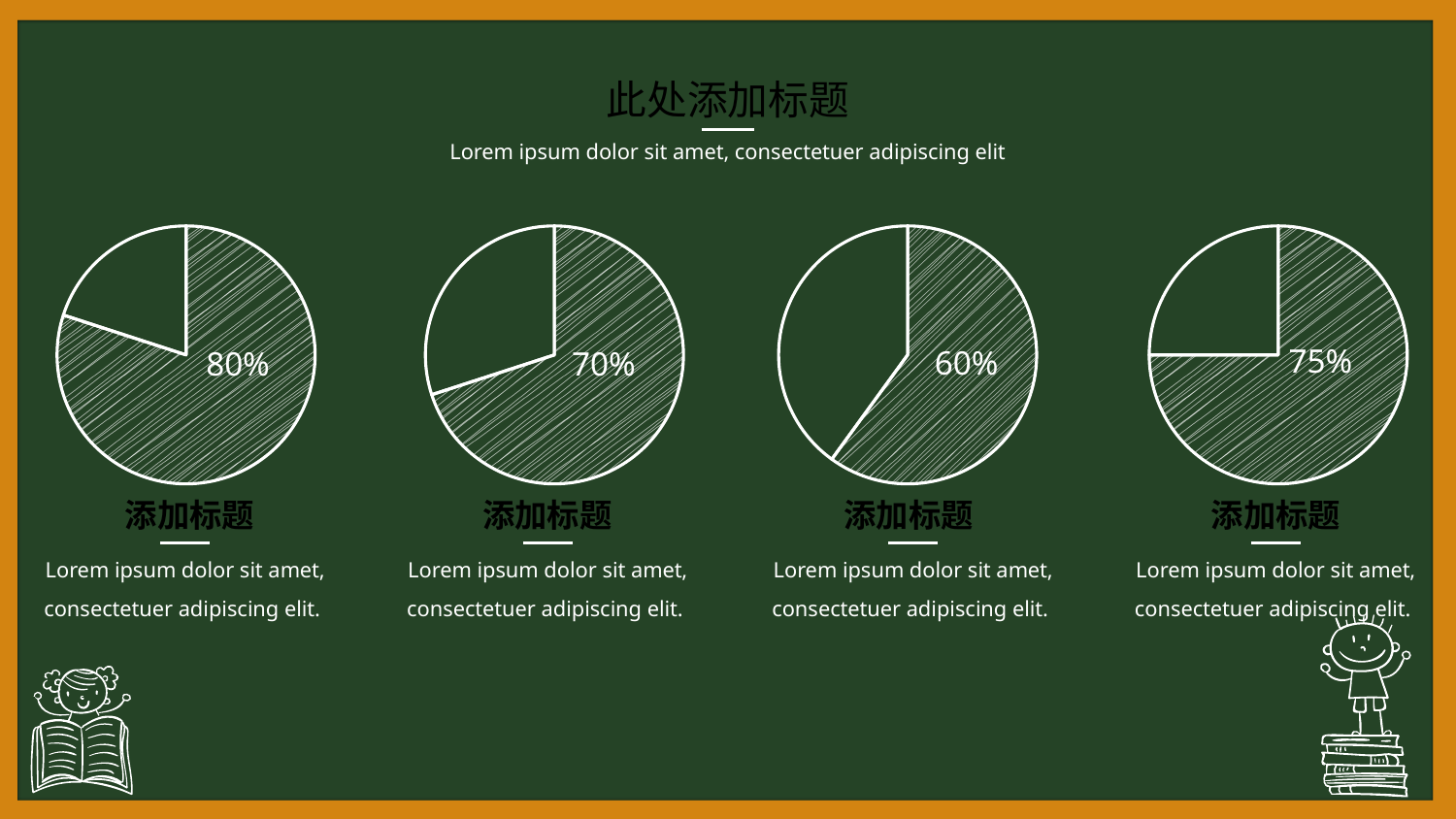
What kind of charts are shown on the slide? Pie charts What value is shown on the rightmost pie chart? 75% Which is larger: the percentage on the second pie chart or the percentage on the rightmost pie chart? The rightmost pie chart (75%) What value is shown on the leftmost pie chart? 80% Which pie chart shows the lowest percentage? The third pie chart from the left (60%) What value is shown on the third pie chart from the left? 60% What is the main title at the top of the slide? 此处添加标题 What is the difference between the percentage on the leftmost pie chart and the percentage on the third pie chart? 20 percentage points What value is shown on the second pie chart from the left? 70% How many pie charts are on the slide? 4 On the rightmost pie chart, what share of the pie does the unhatched (plain) slice represent? 25% Which pie chart shows the highest percentage? The leftmost pie chart (80%)